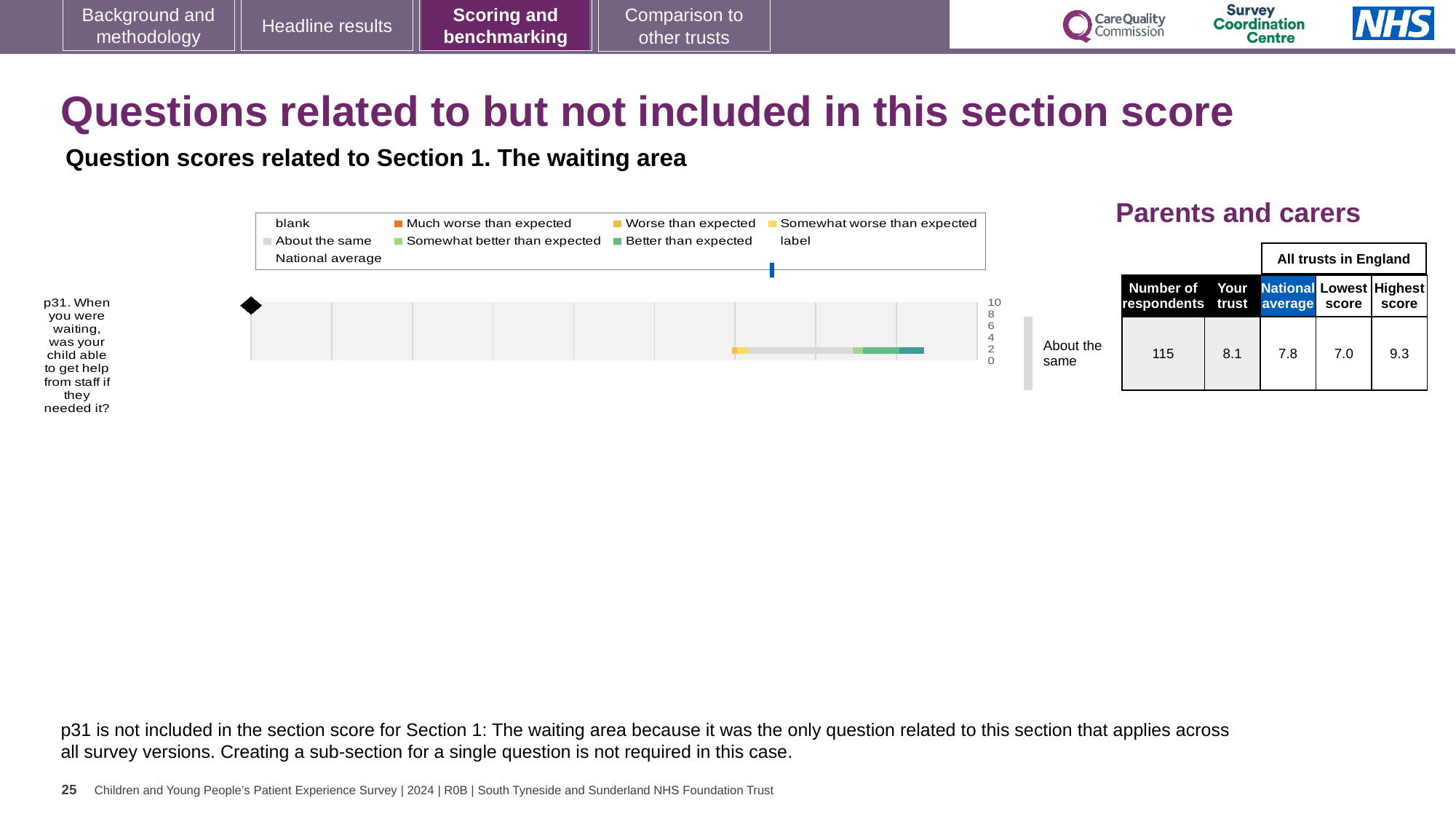
What kind of chart is used to show the p31 question score? bar chart Which question is plotted in the chart? p31. When you were waiting, was your child able to get help from staff if they needed it? How many survey questions are plotted in the chart? 1 What is the highest value shown on the chart's axis? 10 According to the table beside the chart, how many respondents answered p31? 115 According to the table beside the chart, what is the score for Your trust on p31? 8.1 According to the table beside the chart, what is the National average score for p31? 7.8 What is the difference between the Highest score and the Lowest score for p31 in the table beside the chart? 2.3 According to the table beside the chart, what is the Lowest score among all trusts in England for p31? 7.0 What benchmark category is the trust's p31 score placed in, as labelled next to the chart? About the same Is the Your trust score for p31 higher or lower than the National average? higher According to the table beside the chart, what is the Highest score among all trusts in England for p31? 9.3